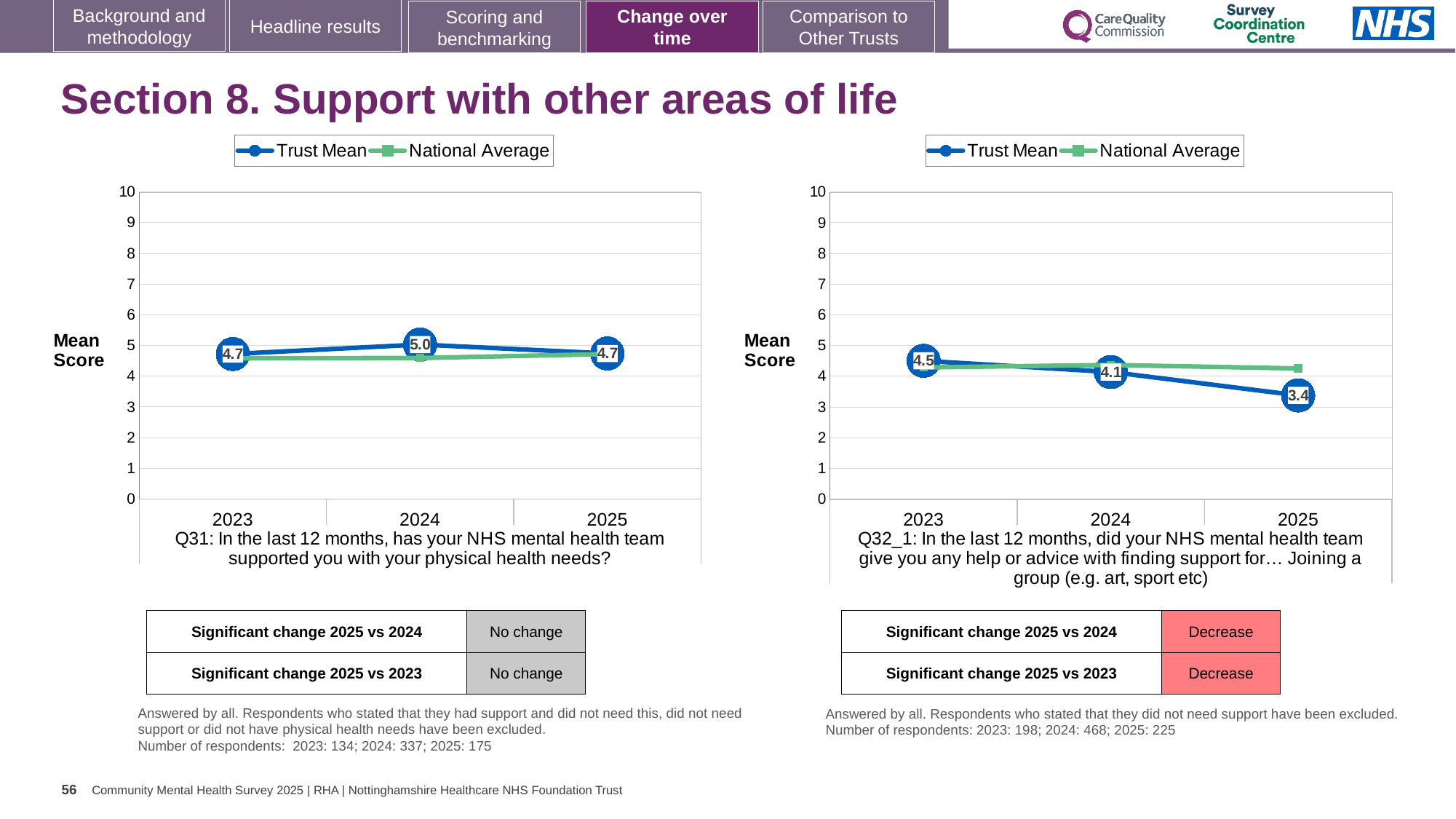
How many series does the legend of the left chart (Q31) list? 2 On the left chart (Q31), what is the difference between the Trust Mean in 2024 and in 2025? 0.3 On the right chart (Q32_1), is the Trust Mean for 2025 greater or less than 4? less On the right chart (Q32_1), in which year is the Trust Mean lowest? 2025 On the left chart (Q31), what is the Trust Mean for 2025? 4.7 On the right chart (Q32_1), what is the Trust Mean for 2025? 3.4 What kind of chart is the right chart (Q32_1)? line chart On the left chart (Q31), what is the Trust Mean for 2024? 5.0 On the right chart (Q32_1), what is the difference between the Trust Mean in 2023 and in 2025? 1.1 On the right chart (Q32_1), does the Trust Mean rise or fall from 2023 to 2025? fall On the left chart (Q31), in which year is the Trust Mean highest? 2024 On the right chart (Q32_1), what is the Trust Mean for 2023? 4.5